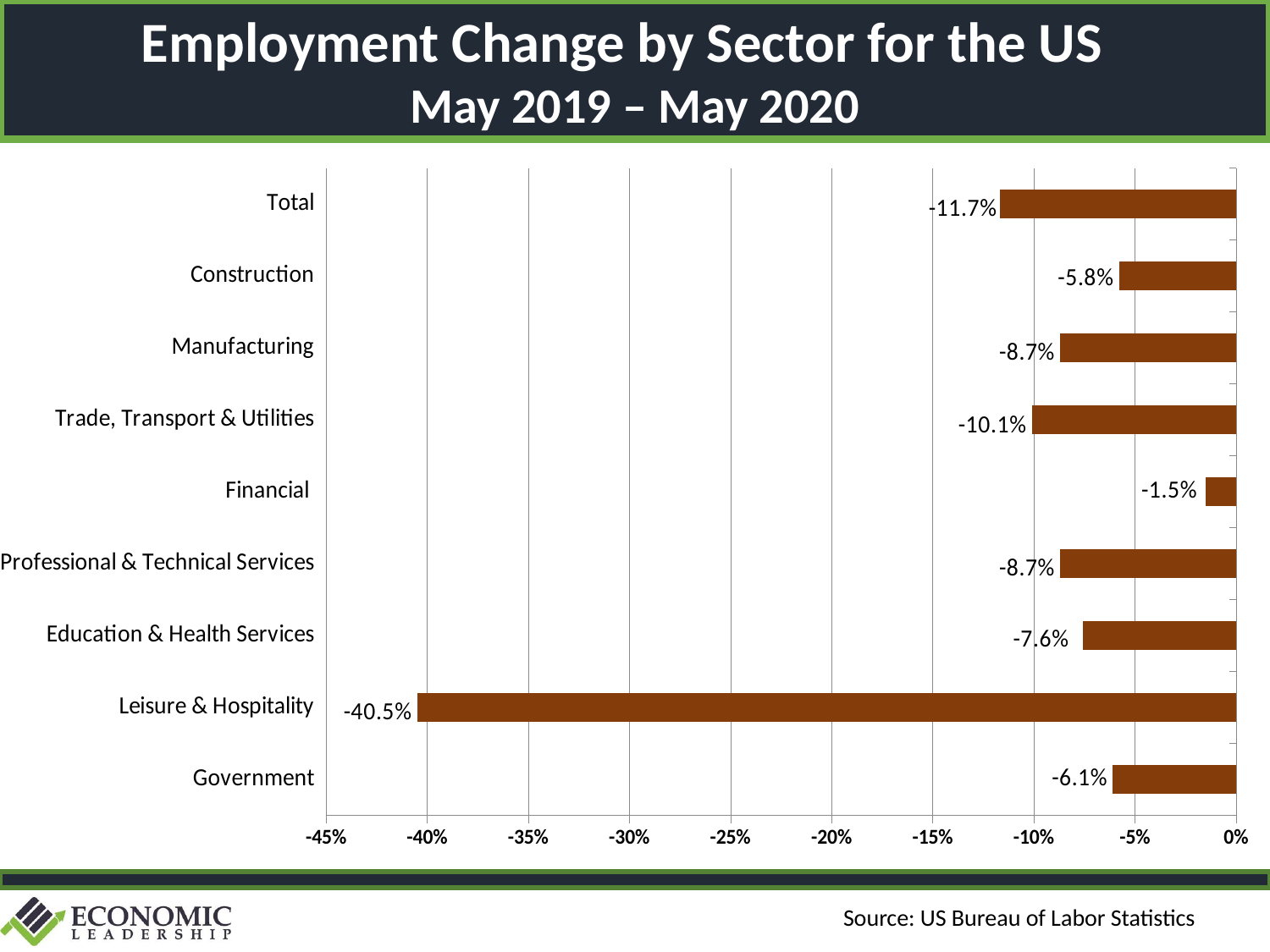
How many categories are plotted on the chart? 9 What is the difference between the employment change for Construction and Government? 0.3 percentage points What is the employment change for Leisure & Hospitality? -40.5% Which sector shows the largest employment decline? Leisure & Hospitality What is the source cited for the chart data? US Bureau of Labor Statistics What is the employment change shown for Total? -11.7% What kind of chart is shown on the slide? Bar chart Is the value for Manufacturing greater or less than -10%? greater What is the employment change for Government? -6.1% What is the employment change for Financial? -1.5% Which sector shows the smallest employment decline? Financial Which sector had a larger employment decline, Trade, Transport & Utilities or Education & Health Services? Trade, Transport & Utilities